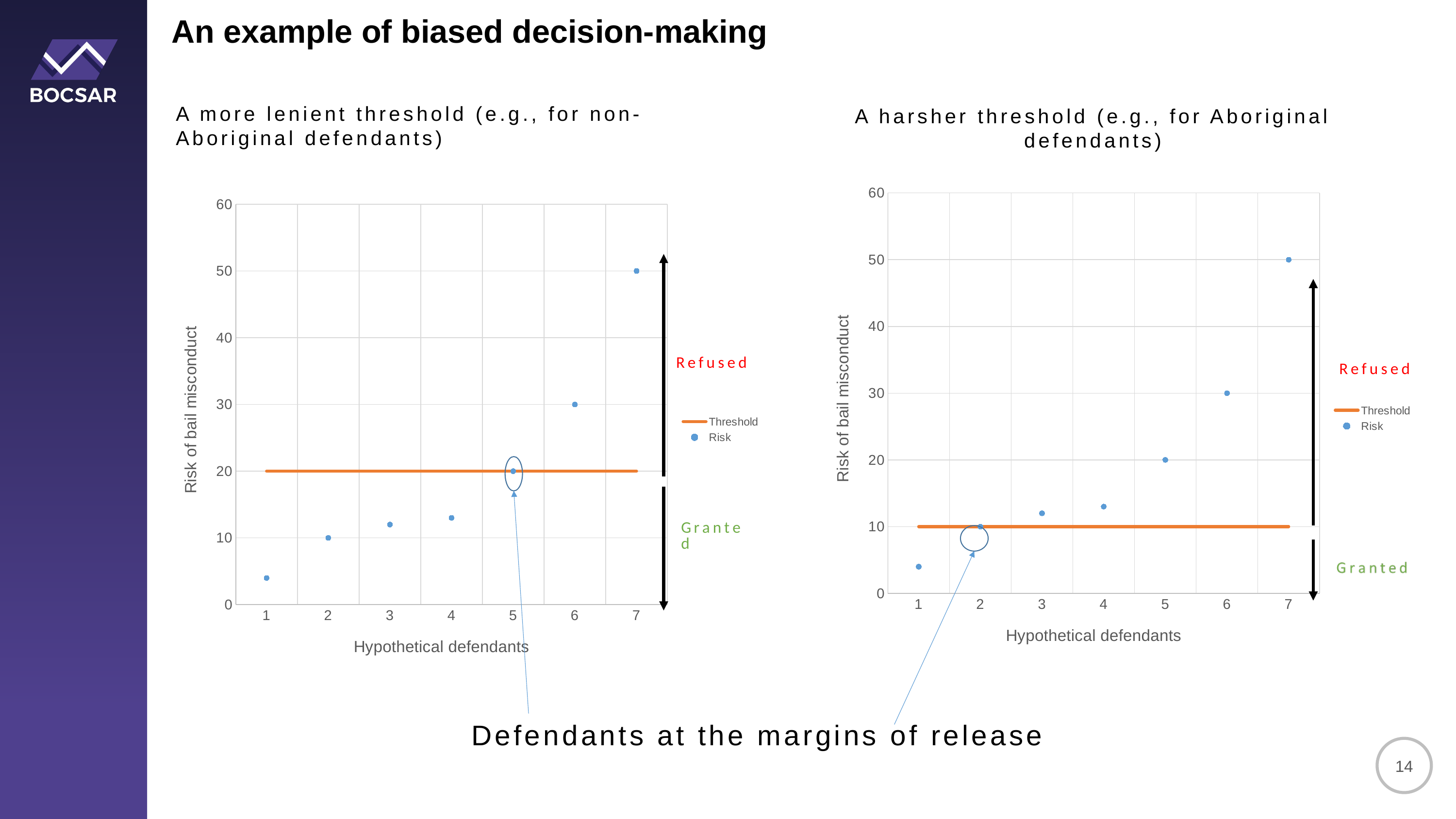
In the left chart (more lenient threshold), do the risk values rise or fall as the defendant number increases from 1 to 7? Rise How many series does the legend of the right chart (harsher threshold) list? 2 In the left chart (more lenient threshold), at what value on the y axis is the Threshold line drawn? 20 In the right chart (harsher threshold), is the risk value for hypothetical defendant 4 greater or less than 20? less In the left chart (more lenient threshold), what is the risk of bail misconduct for hypothetical defendant 7? 50 In the right chart (harsher threshold), which hypothetical defendant has the lowest risk of bail misconduct? 1 In the left chart (more lenient threshold), which hypothetical defendant has the highest risk of bail misconduct? 7 In the right chart (harsher threshold), at what value on the y axis is the Threshold line drawn? 10 In the right chart (harsher threshold), what is the risk of bail misconduct for hypothetical defendant 6? 30 In the left chart (more lenient threshold), how many hypothetical defendants are plotted on the x axis? 7 What kind of chart is the left chart, 'A more lenient threshold (e.g., for non-Aboriginal defendants)'? Scatter chart What are the two legend entries shown in the left chart (more lenient threshold)? Threshold and Risk